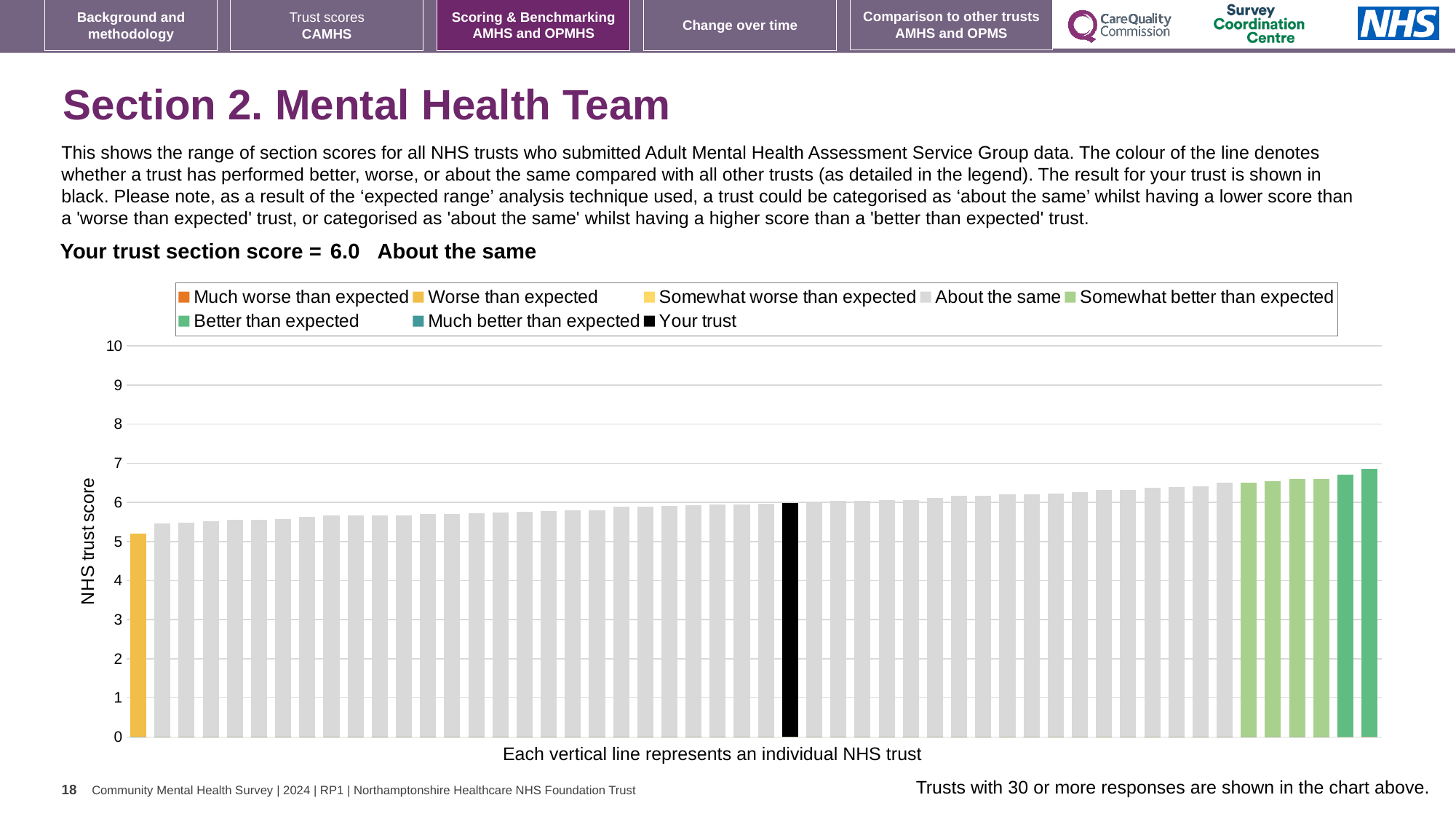
Is the value of the leftmost (yellow) bar greater or less than 6? less What is the highest value shown on the vertical axis of the chart? 10 Is the value of the black 'Your trust' bar greater or less than 5? greater What is the section score for your trust shown on the slide? 6.0 How many entries does the chart legend list? 8 Is the value of the rightmost bar greater or less than 6? greater Do the bar values rise or fall from left to right along the x axis? Rise What kind of chart is shown on the slide? Bar chart Which is larger, the value of the leftmost bar or the value of the rightmost bar? The rightmost bar What is the label on the vertical axis of the chart? NHS trust score